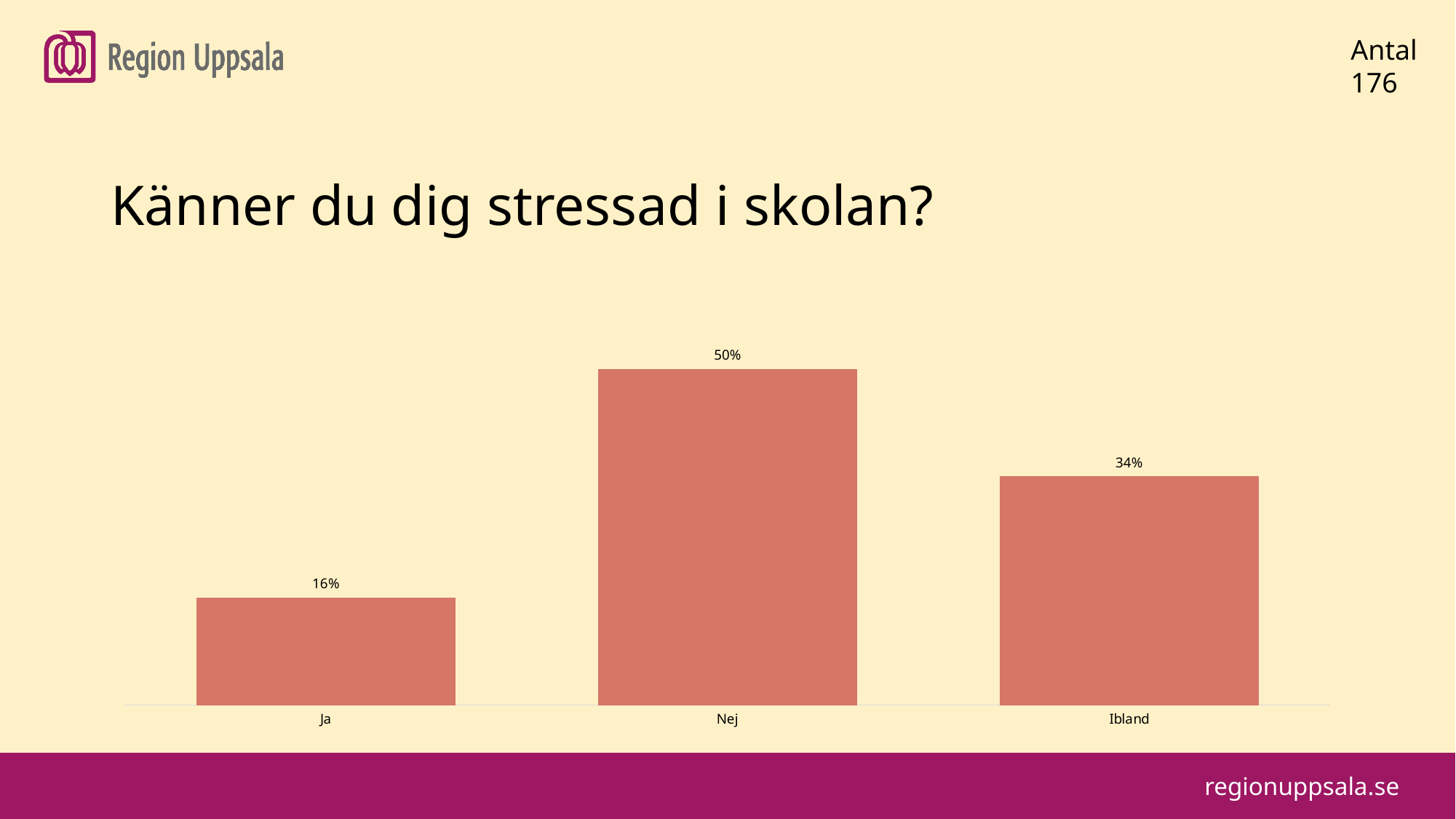
What is the difference between the values for "Nej" and "Ibland"? 16% What is the title of the slide above the chart? Känner du dig stressad i skolan? Which is larger, the value for "Ja" or the value for "Ibland"? Ibland What number is shown next to "Antal" in the top right corner of the slide? 176 What is the difference between the values for "Ibland" and "Ja"? 18% What kind of chart is shown on the slide? Bar chart How many categories are shown in the chart? 3 What is the value for "Ibland"? 34% Which category has the highest value? Nej What is the value for "Ja"? 16% Which category has the lowest value? Ja What is the value for "Nej"? 50%